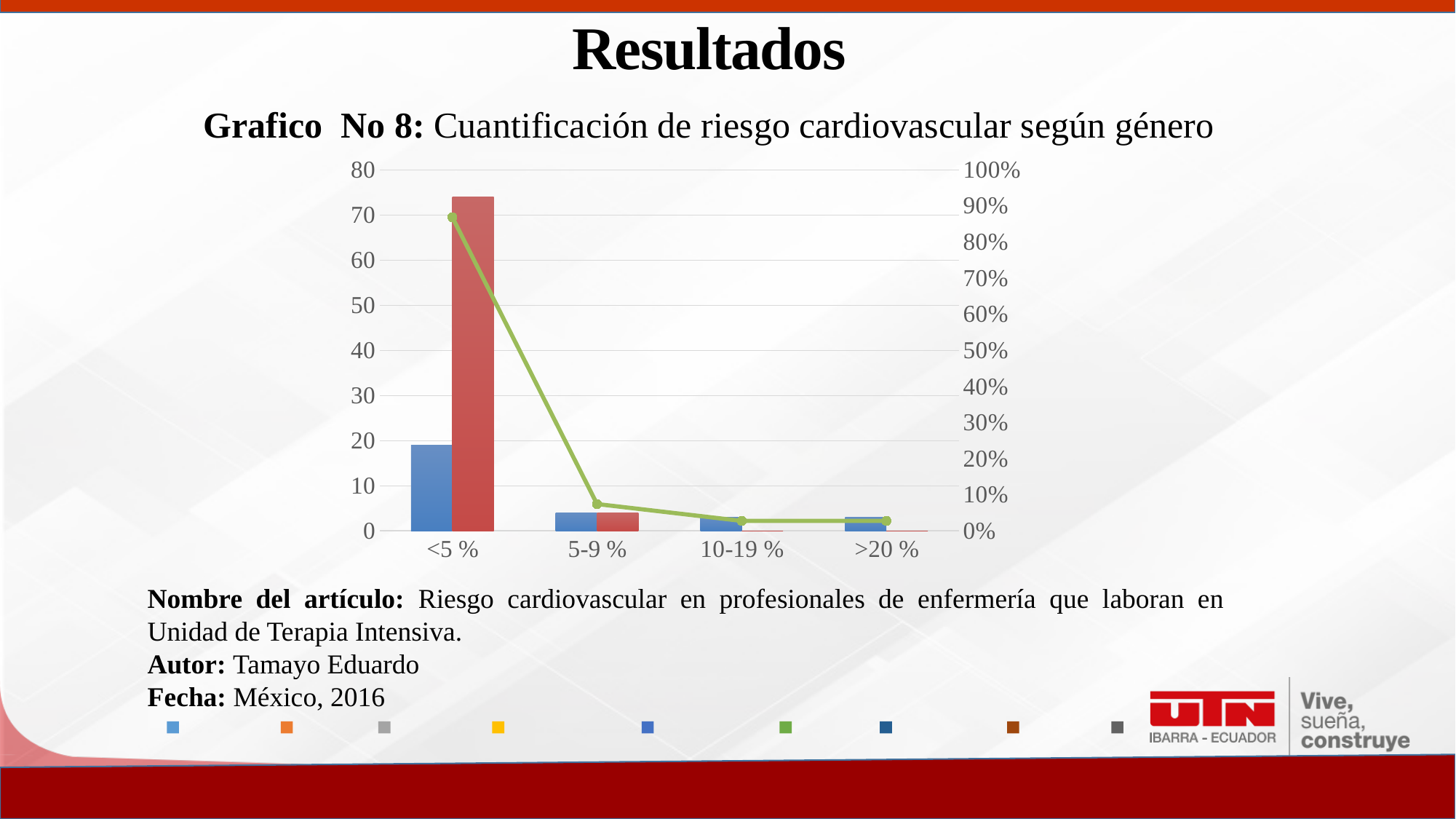
On the right-hand axis, is the green line value for 5-9 % greater or less than 10%? less Is the value of the red bar for 5-9 % greater or less than 10? less Does the green line rise or fall from <5 % to >20 %? It falls What is the title of the chart? Grafico No 8: Cuantificación de riesgo cardiovascular según género How many categories are shown on the x axis of the chart? 4 Is the value of the red bar for <5 % greater or less than 70? greater Which category has the tallest red bar? <5 % In the <5 % category, which bar is taller, the blue bar or the red bar? The red bar What kind of chart is shown on the slide? A bar chart combined with a line Which category has the tallest blue bar? <5 %